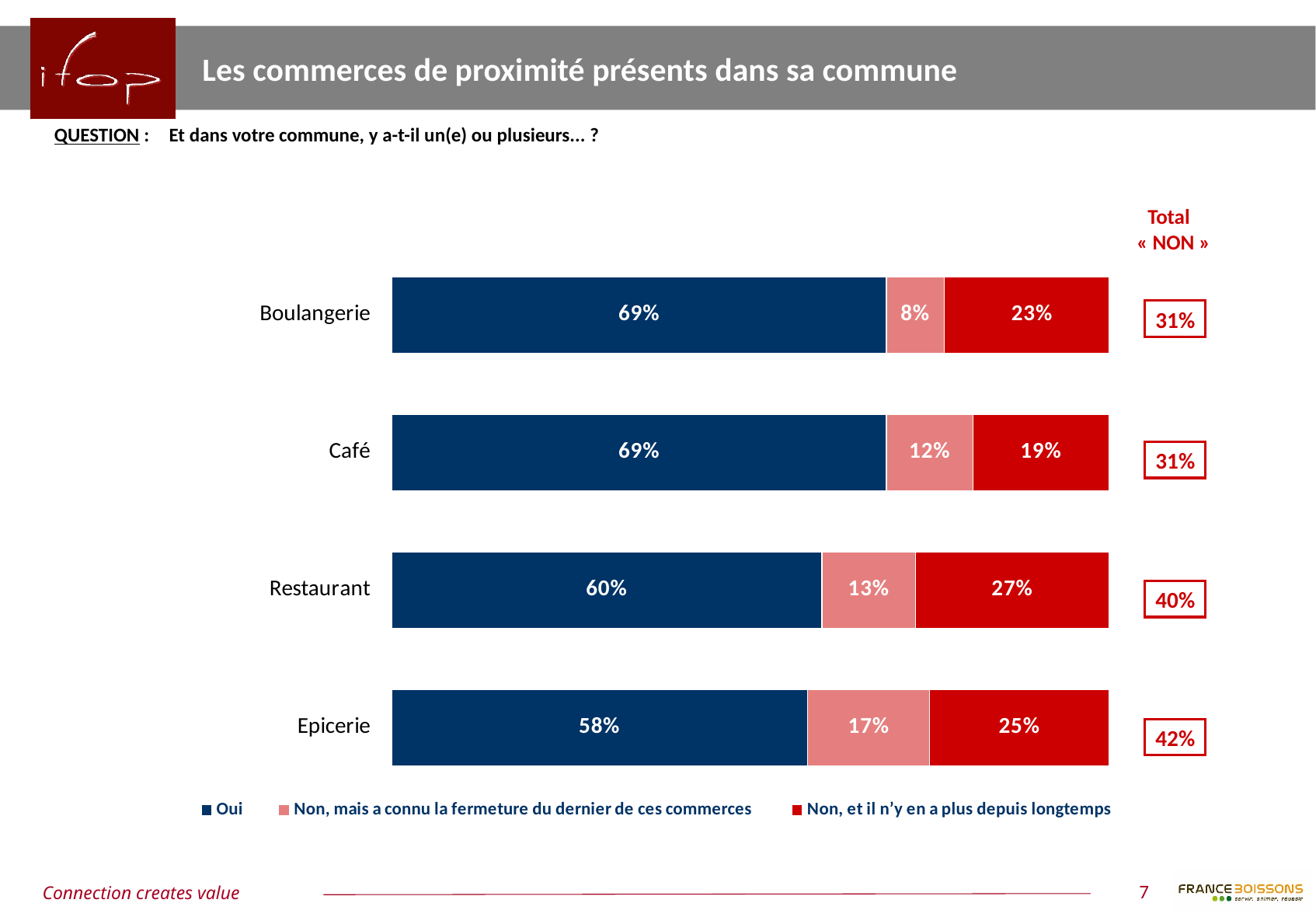
What kind of chart is shown on the slide? Stacked bar chart Which is larger: the "Non, mais a connu la fermeture du dernier de ces commerces" value for Café or for Boulangerie? Café How many categories are shown in the chart? 4 Which category has the lowest "Oui" value? Epicerie What is the "Oui" value for Restaurant? 60% What is the "Non, et il n'y en a plus depuis longtemps" value for Boulangerie? 23% What is the "Non, mais a connu la fermeture du dernier de ces commerces" value for Epicerie? 17% What is the Total « NON » value shown for Restaurant? 40% How many series does the legend list? 3 Which category has the highest "Non, et il n'y en a plus depuis longtemps" value? Restaurant What is the difference between the "Oui" values for Café and Epicerie? 11% What is the total of the two "Non" segments for Epicerie? 42%